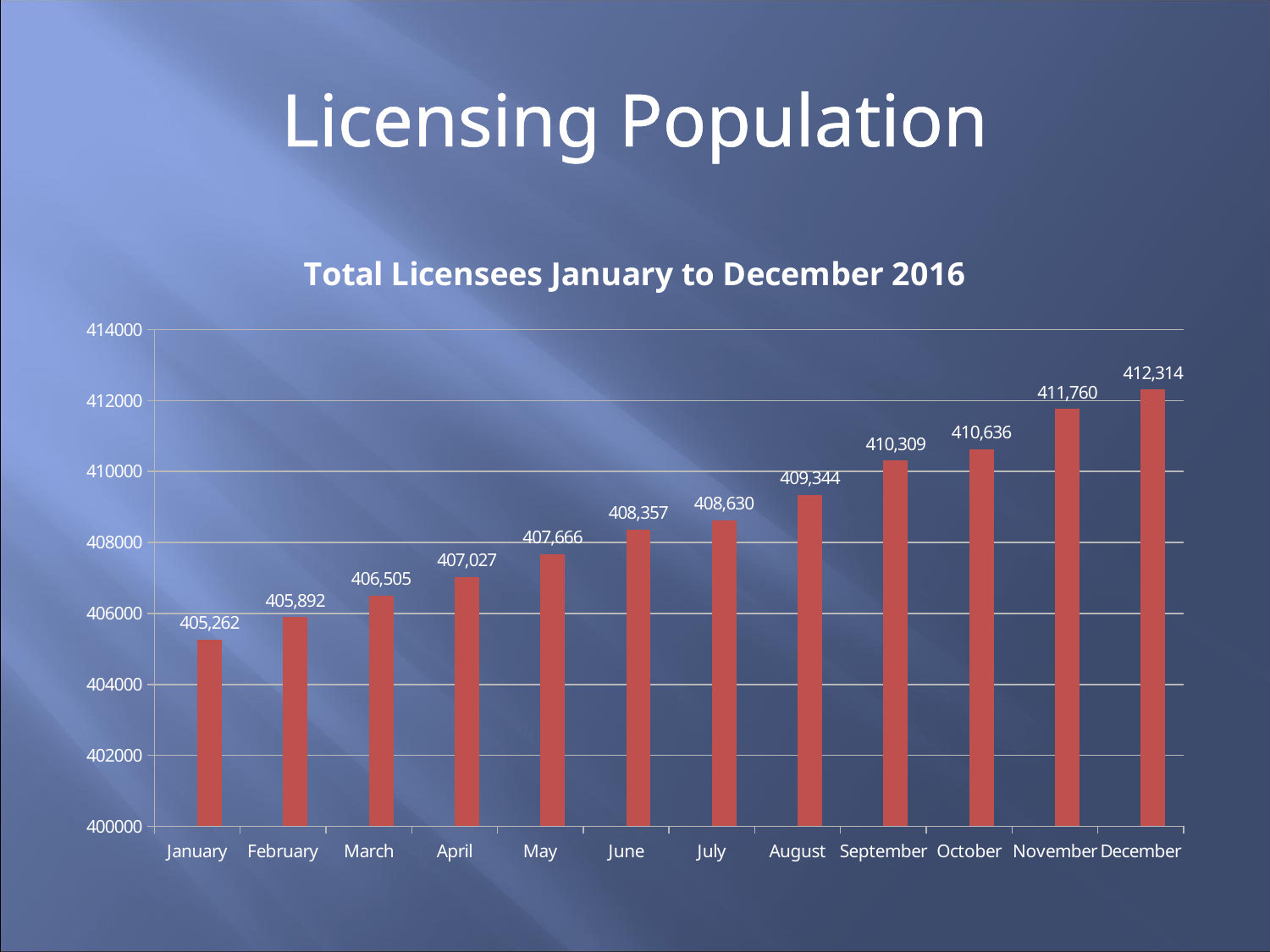
What kind of chart is shown on the slide? bar chart What is the difference between the June and May values? 691 Which month has the lowest value? January How many months are shown on the x axis? 12 Is the value for April greater or less than 408000? less What is the value for March? 406,505 Which is larger, the value for July or the value for September? September What is the difference between the December and January values? 7,052 What is the value for August? 409,344 Do the values rise or fall from January to December? rise What is the value for November? 411,760 Which month has the highest value? December